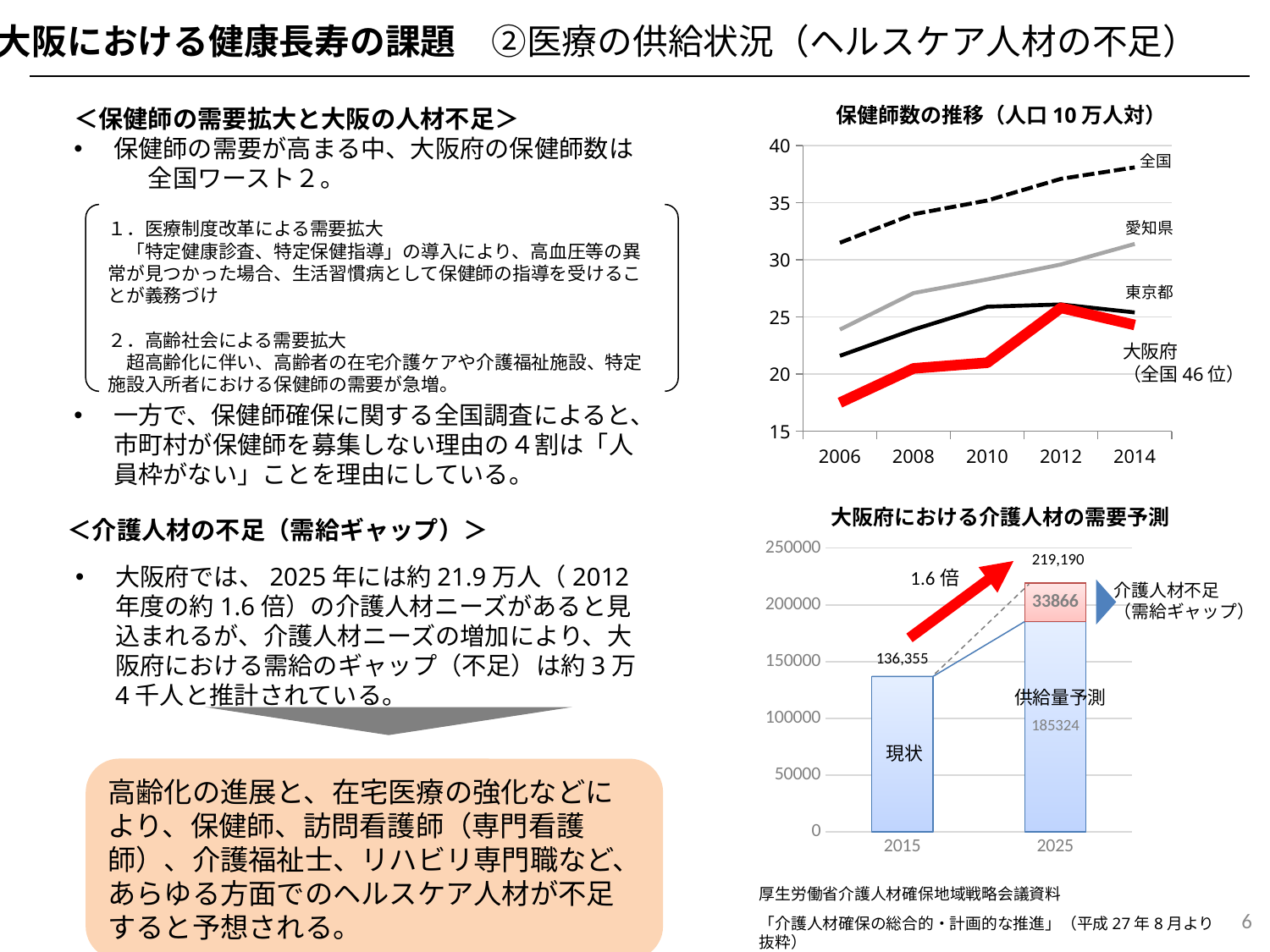
In the chart titled 大阪府における介護人材の需要予測, what is the total value labelled at the top of the 2025 bar? 219,190 In the chart titled 保健師数の推移（人口10万人対）, is the value for 全国 in 2014 greater or less than 35? greater In the chart titled 保健師数の推移（人口10万人対）, does the 全国 line rise or fall from 2006 to 2014? rise In the chart titled 保健師数の推移（人口10万人対）, which series has the highest value in 2014? 全国 In the chart titled 大阪府における介護人材の需要予測, what is the value labelled for 2015? 136,355 In the chart titled 保健師数の推移（人口10万人対）, how many years are shown on the x axis? 5 In the chart titled 保健師数の推移（人口10万人対）, is the value for 大阪府 in 2006 greater or less than 20? less In the chart titled 大阪府における介護人材の需要予測, what is the difference between the 2025 total (219,190) and the 2015 value (136,355)? 82,835 In the chart titled 保健師数の推移（人口10万人対）, how many series (lines) are plotted? 4 In the chart titled 大阪府における介護人材の需要予測, what is the value of the 供給量予測 segment of the 2025 bar? 185324 In the chart titled 保健師数の推移（人口10万人対）, which series has the lowest value in 2006? 大阪府 In the chart titled 保健師数の推移（人口10万人対）, what kind of chart is it? line chart